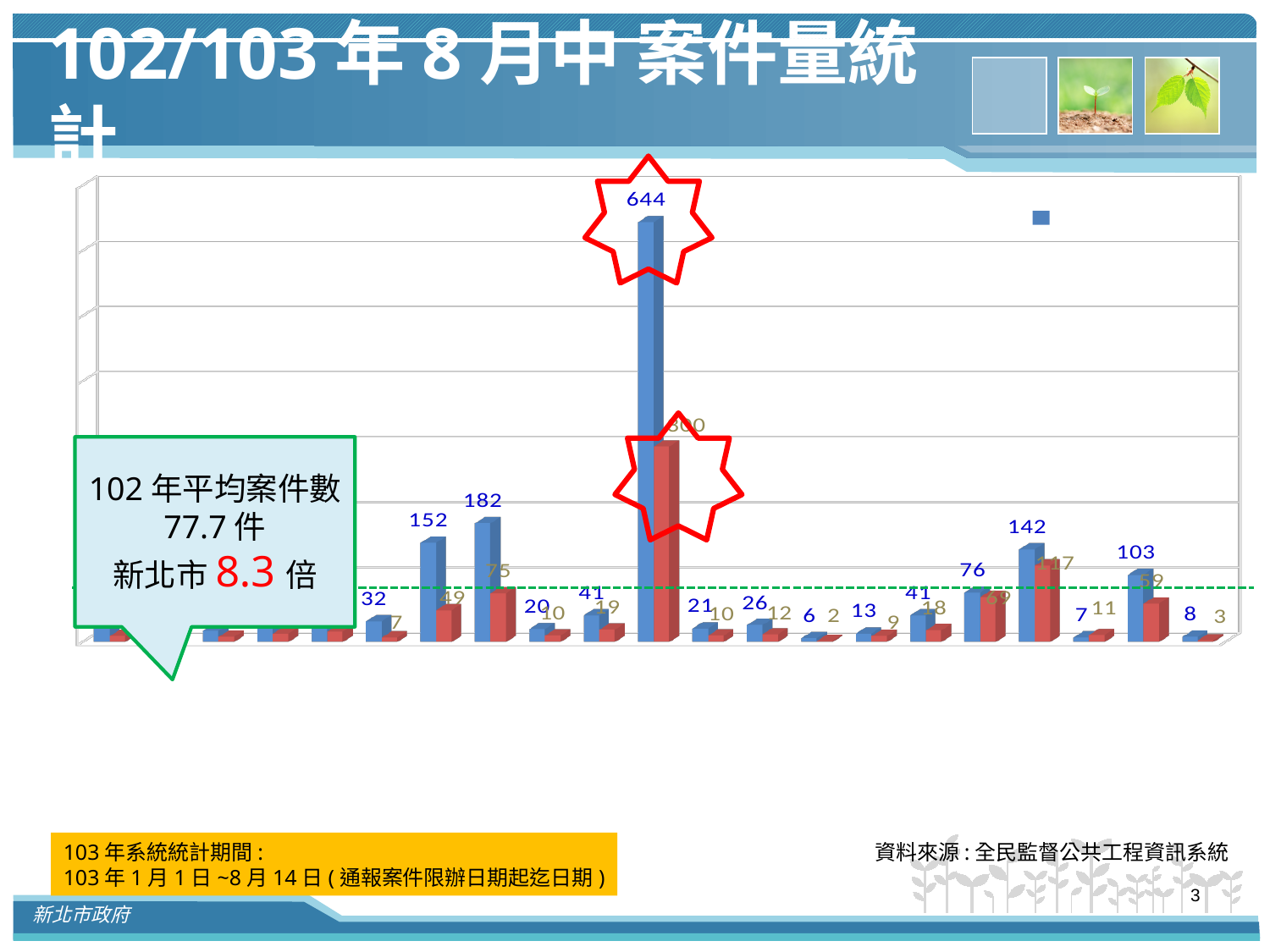
What is the second-highest value labeled on a blue bar in the chart? 182 What two colours are used for the bars in the chart? blue and red What is the difference between the tallest blue bar (644) and the second-tallest blue bar (182)? 462 What is the difference between the blue bar labeled 103 and the red bar next to it labeled 59? 44 What is the difference between the blue bar labeled 152 and the red bar next to it labeled 49? 103 In the pair of bars labeled 142 and 117, which bar is taller, the blue one or the red one? the blue one (142) What is the highest value labeled on the chart? 644 What is the lowest value labeled on a red bar in the chart? 2 According to the callout on the chart, what is the 102年 average number of cases (102年平均案件數)? 77.7 件 What kind of chart is shown on the slide? bar chart What is the lowest value labeled on a blue bar in the chart? 6